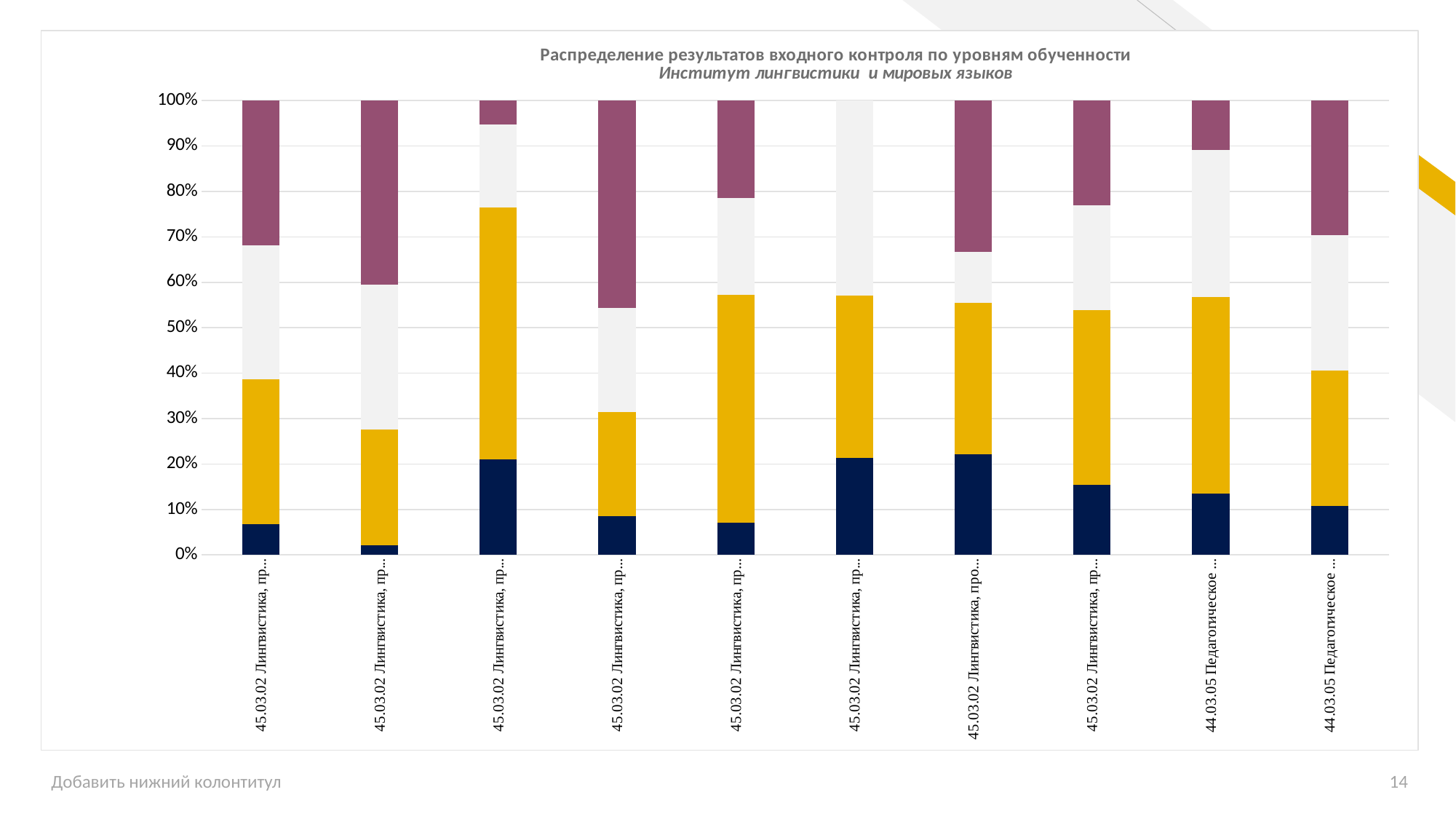
What is the first line of the chart's title? Распределение результатов входного контроля по уровням обученности In the ninth bar from the left, is the top of the yellow segment greater or less than 50%? greater In the first bar from the left, is the top of the dark blue segment greater or less than 10%? less In the third bar from the left, is the top of the yellow segment greater or less than 70%? greater How many bars are plotted in the chart? 10 Which bar has no purple segment at the top? The sixth bar from the left What is the highest value shown on the vertical axis? 100% What kind of chart is shown on the slide? Stacked bar chart Which bar has the smallest dark blue segment? The second bar from the left